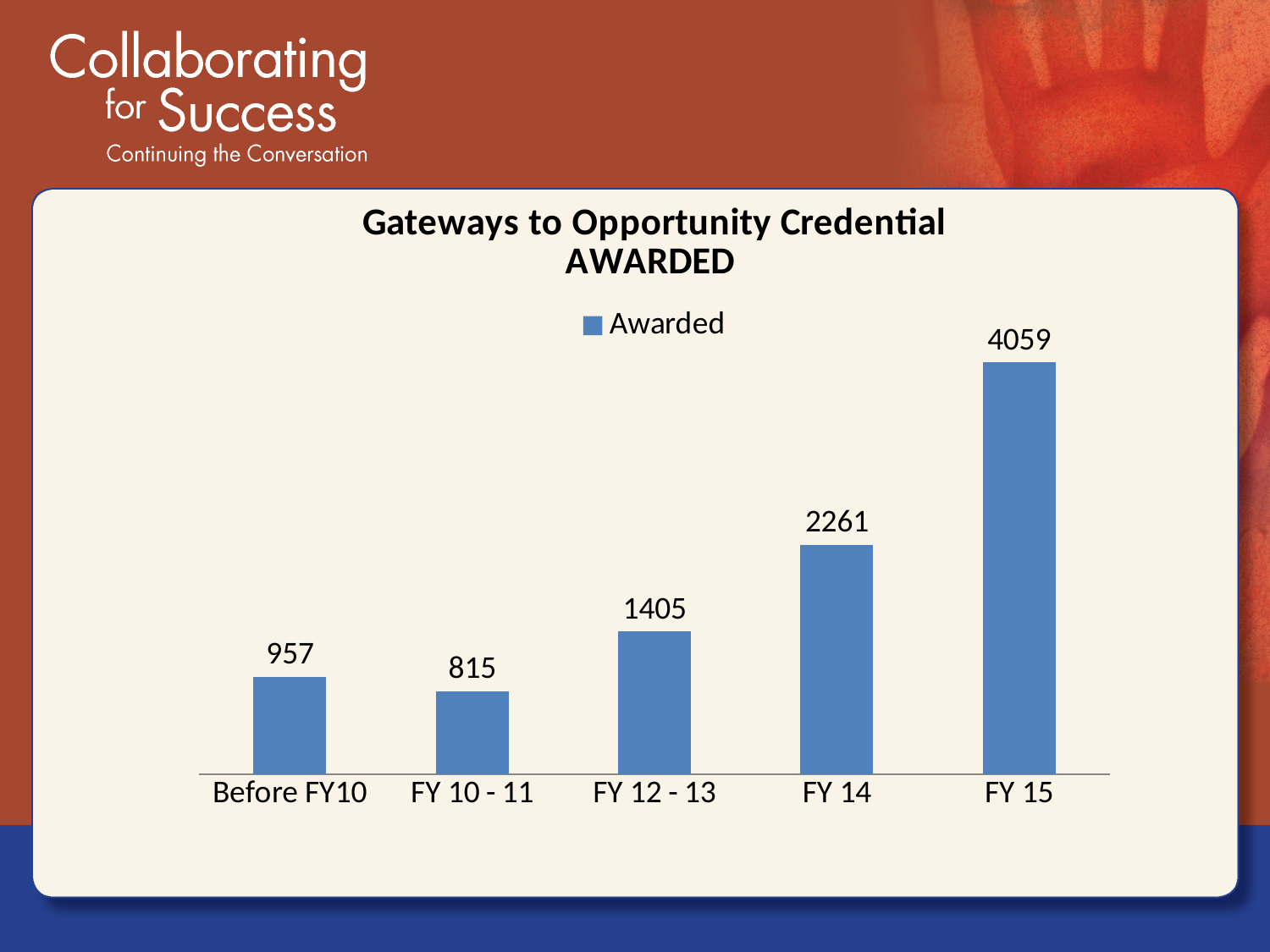
What is the difference between the values for Before FY10 and FY 10 - 11? 142 What is the title of the chart? Gateways to Opportunity Credential AWARDED What kind of chart is shown? bar chart How many categories are shown on the x axis? 5 Which category has the highest value? FY 15 Which category has the lowest value? FY 10 - 11 What is the difference between the values for FY 15 and FY 14? 1798 What value is shown for Before FY10? 957 Which is larger, the value for FY 14 or the value for FY 12 - 13? FY 14 What value is shown for FY 15? 4059 How many series does the legend list? 1 What value is shown for FY 12 - 13? 1405